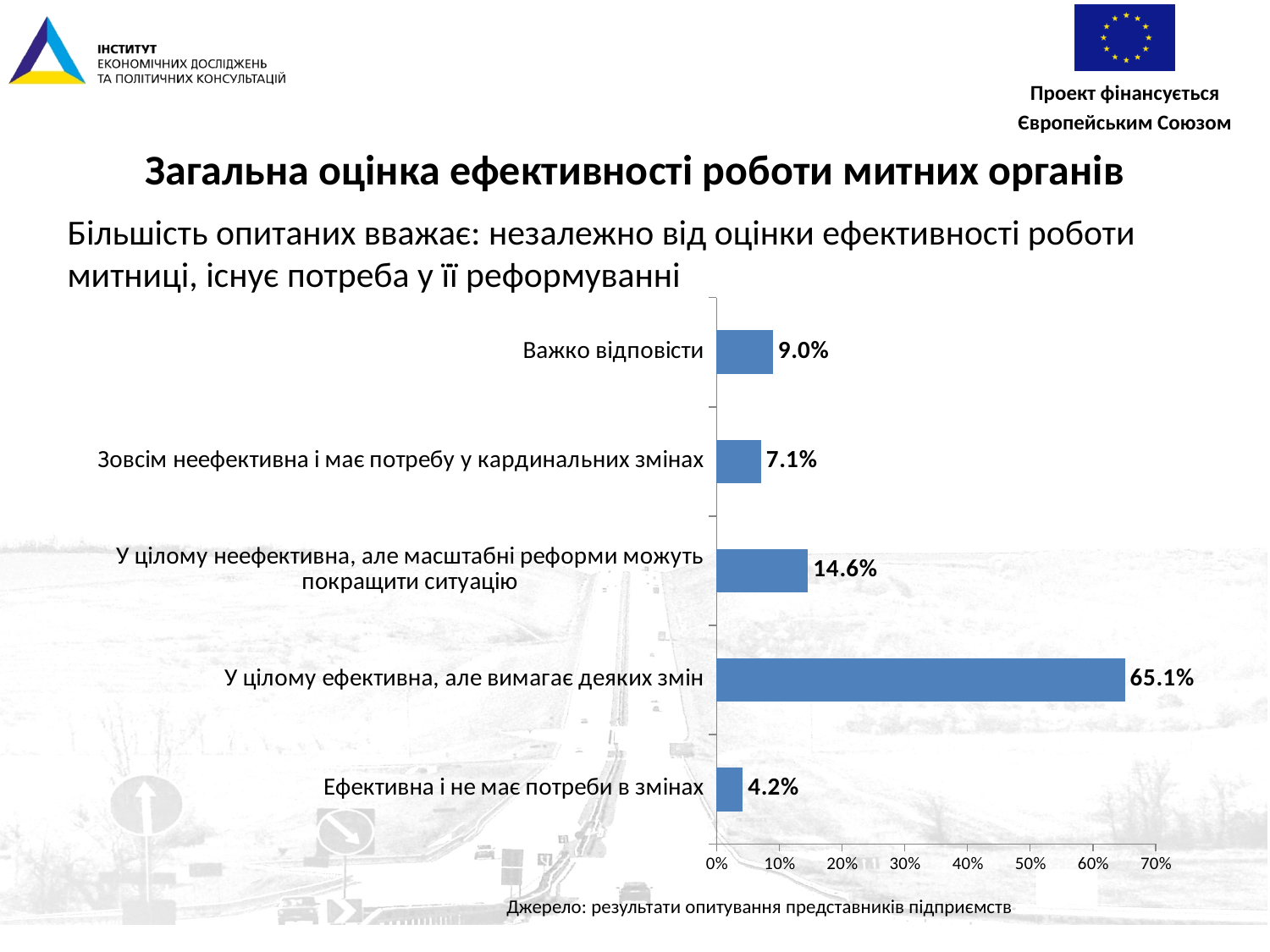
What is the value for "У цілому ефективна, але вимагає деяких змін"? 65.1% What is the difference between the values for "У цілому неефективна, але масштабні реформи можуть покращити ситуацію" and "Зовсім неефективна і має потребу у кардинальних змінах"? 7.5% How many categories are shown in the chart? 5 What is the value for "Ефективна і не має потреби в змінах"? 4.2% What is the value for "Зовсім неефективна і має потребу у кардинальних змінах"? 7.1% What is the value for "Важко відповісти"? 9.0% What is the title of the slide containing the chart? Загальна оцінка ефективності роботи митних органів Which category has the lowest value? Ефективна і не має потреби в змінах What kind of chart is shown on the slide? bar chart Which is larger: the value for "Важко відповісти" or the value for "Зовсім неефективна і має потребу у кардинальних змінах"? Важко відповісти Is the value for "У цілому ефективна, але вимагає деяких змін" greater or less than 60%? greater Which category has the highest value? У цілому ефективна, але вимагає деяких змін